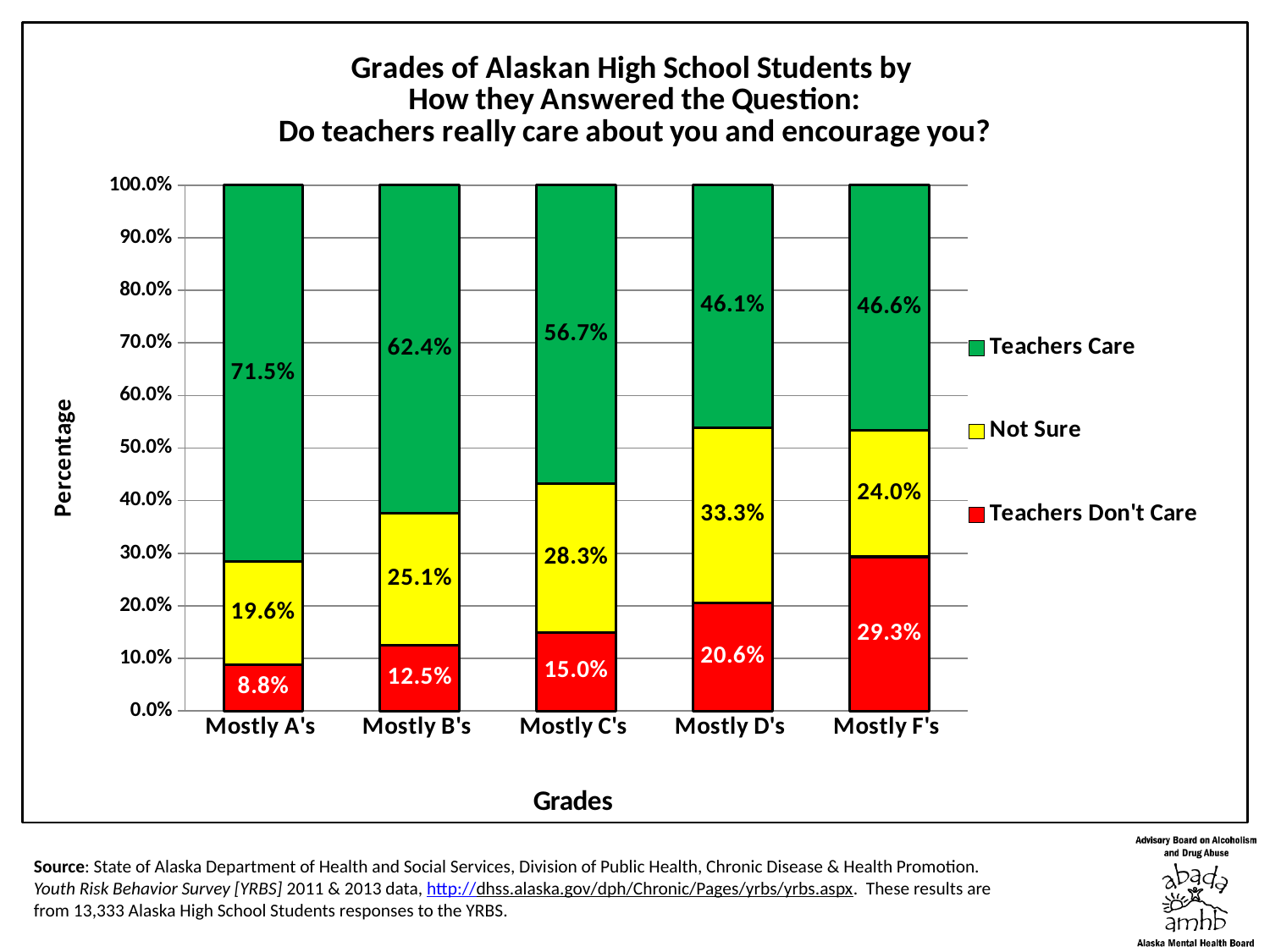
What is the Not Sure value for Mostly C's? 28.3% Which is larger: the Not Sure value for Mostly D's or for Mostly F's? Mostly D's Which grade category has the lowest Teachers Don't Care percentage? Mostly A's What kind of chart is shown on the slide? Stacked bar chart Which grade category has the highest Teachers Care percentage? Mostly A's Does the Teachers Don't Care percentage rise or fall from Mostly A's to Mostly F's? Rise What percentage of students with Mostly A's answered Teachers Care? 71.5% Which colour represents the Not Sure series in the legend? Yellow How many grade categories are shown on the x axis? 5 How many series does the legend list? 3 What percentage of students with Mostly F's answered Teachers Don't Care? 29.3% What is the difference between the Teachers Care percentages for Mostly A's and Mostly B's? 9.1%